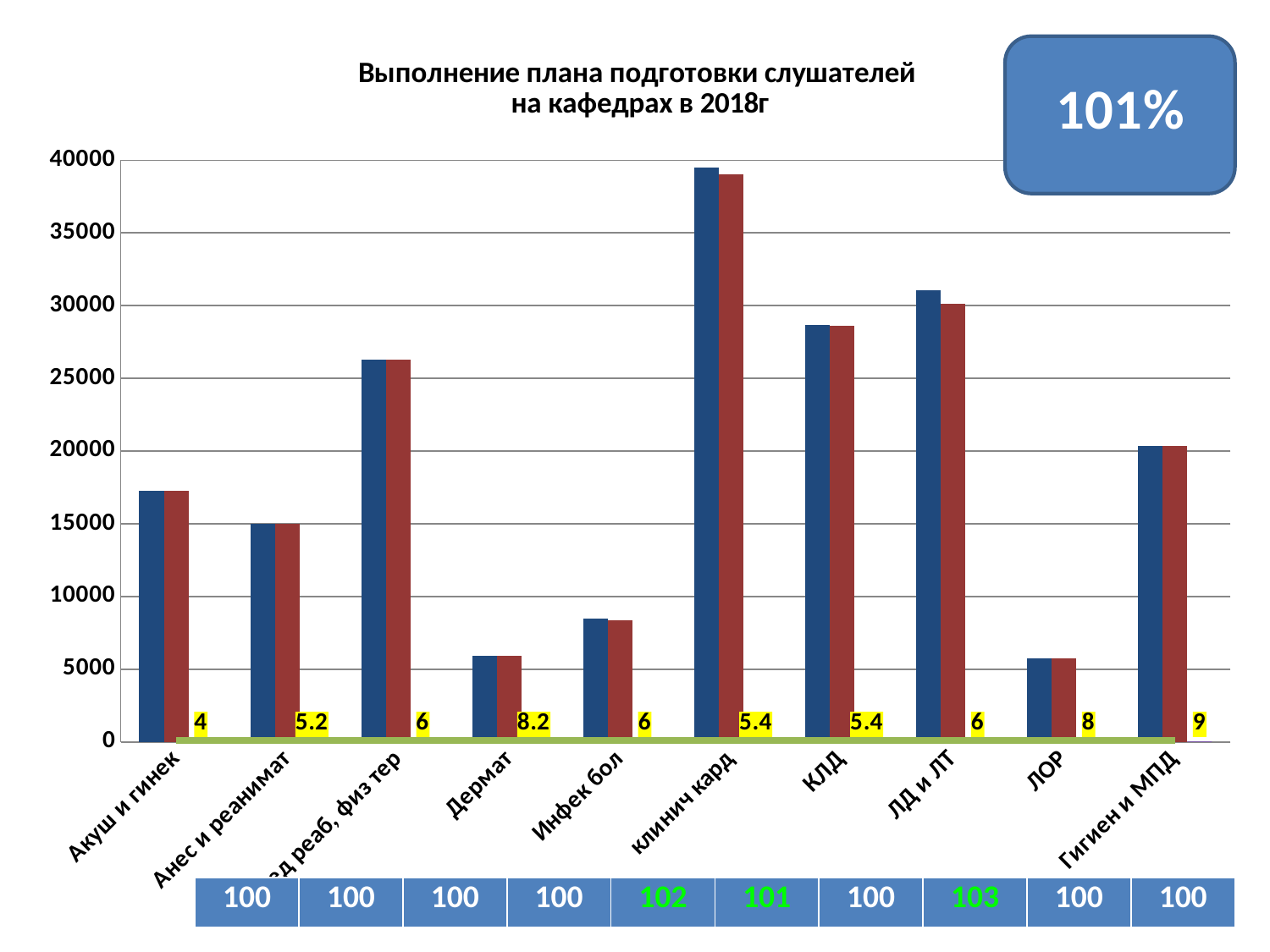
Is the value for Акуш и гинек greater or less than 15000? greater Is the value for Дермат greater or less than 10000? less Is the value for КЛД greater or less than 25000? greater What data label is shown on the green line for Дермат? 8.2 Which has taller bars, клинич кард or ЛД и ЛТ? клинич кард Which category has the tallest bars in the chart? клинич кард How many categories are shown on the x axis of the chart? 10 What is the title of the chart? Выполнение плана подготовки слушателей на кафедрах в 2018г What percentage is shown in the blue rounded box at the top right of the slide? 101% What kind of chart is shown on the slide? combination bar and line chart Which has taller bars, Акуш и гинек or Анес и реанимат? Акуш и гинек